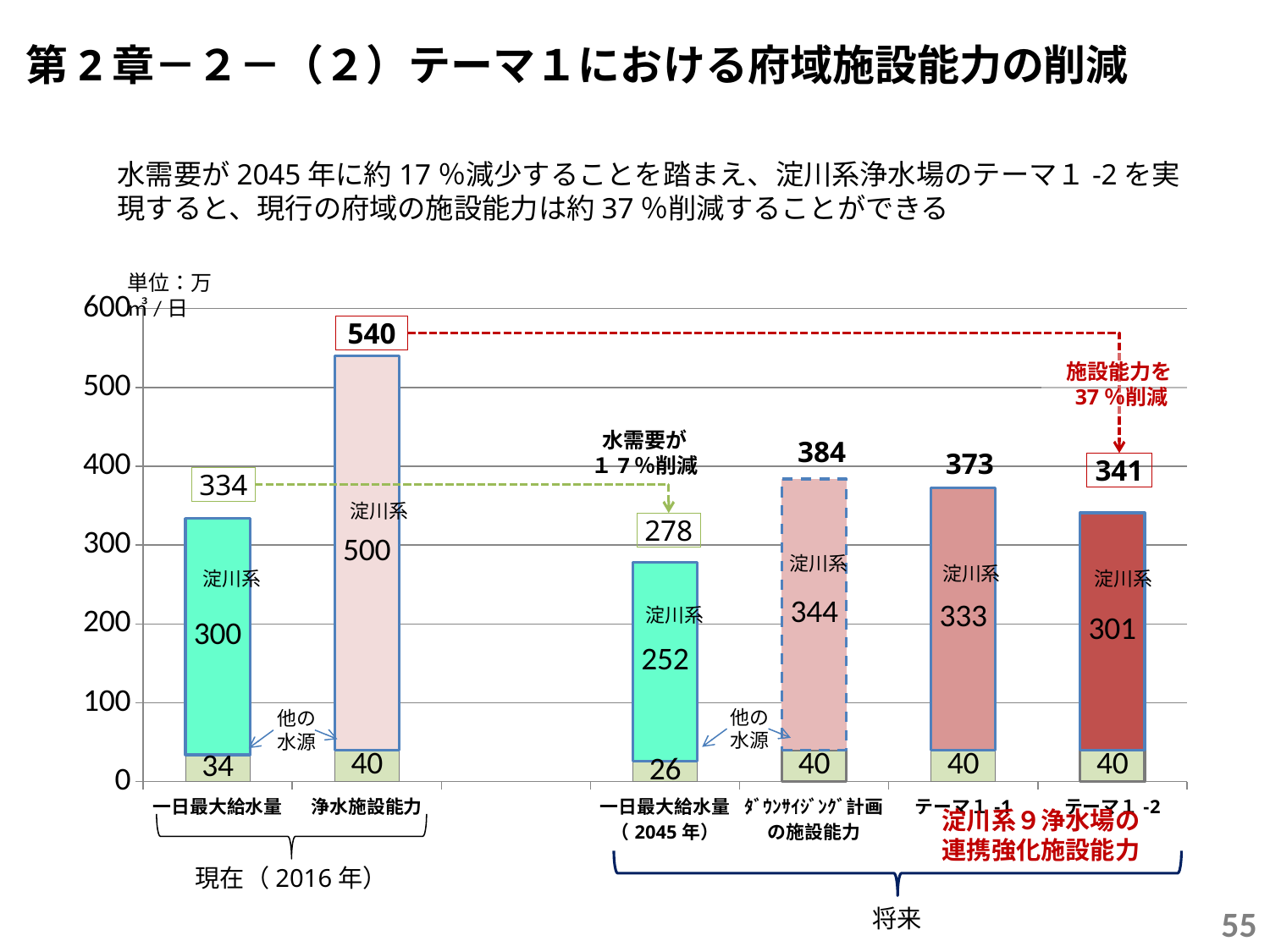
ダウンサイジング計画の施設能力の合計値はいくつですか？ 384 現在（2016年）の浄水施設能力の合計値はいくつですか？ 540 テーマ1-1とテーマ1-2では、どちらの合計値が大きいですか？ テーマ1-1 浄水施設能力（540）とテーマ1-2（341）の差はいくつですか？ 199 グラフの単位は何ですか？ 万㎥/日 グラフには棒がいくつありますか？ 6 合計値が最も小さい棒はどれですか？ 一日最大給水量（2045年） テーマ1-2の淀川系の値はいくつですか？ 301 現在の一日最大給水量の淀川系（300）と他の水源（34）を合計するといくつですか？ 334 これはどの種類のグラフですか？ 棒グラフ 合計値が最も大きい棒はどれですか？ 浄水施設能力 一日最大給水量（2045年）の淀川系の値はいくつですか？ 252